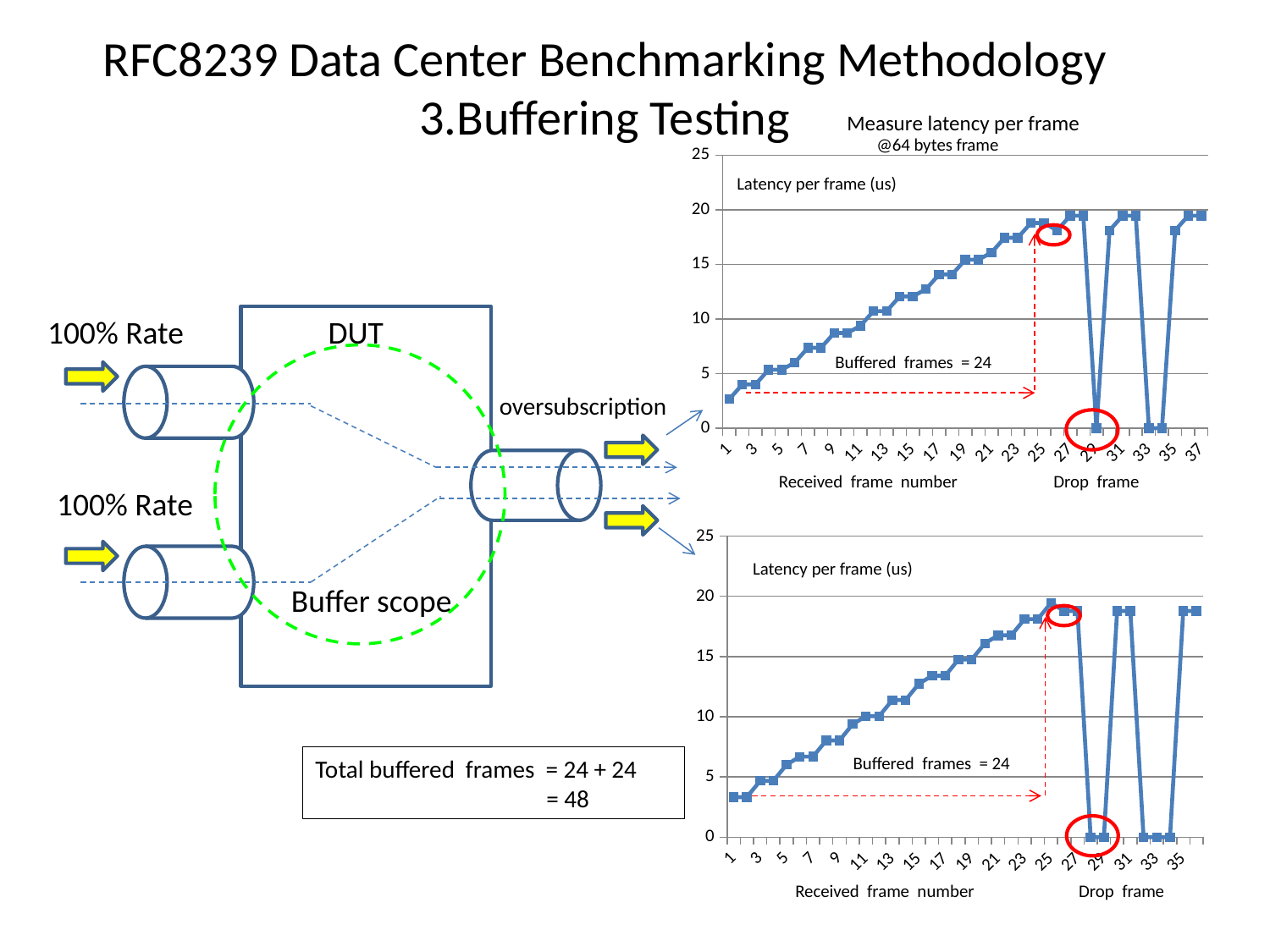
What is the title shown inside the upper chart? Latency per frame (us) What kind of chart is the lower chart on the right of the slide? line chart In the upper chart, what is the lowest latency value plotted (at the drop frames)? 0 In the upper chart, is the latency for received frame 1 greater or less than 5? less In the upper chart, do the latency values rise or fall from received frame 1 to received frame 25? rise In the lower chart, what is the lowest latency value plotted (at the drop frames)? 0 What kind of chart is the upper chart on the right of the slide? line chart In the lower chart, is the latency for received frame 25 greater or less than 15? greater In the lower chart, do the latency values rise or fall from received frame 1 to received frame 25? rise According to the annotation in the lower chart, how many buffered frames are there? 24 In the upper chart, is the latency for received frame 25 greater or less than 15? greater